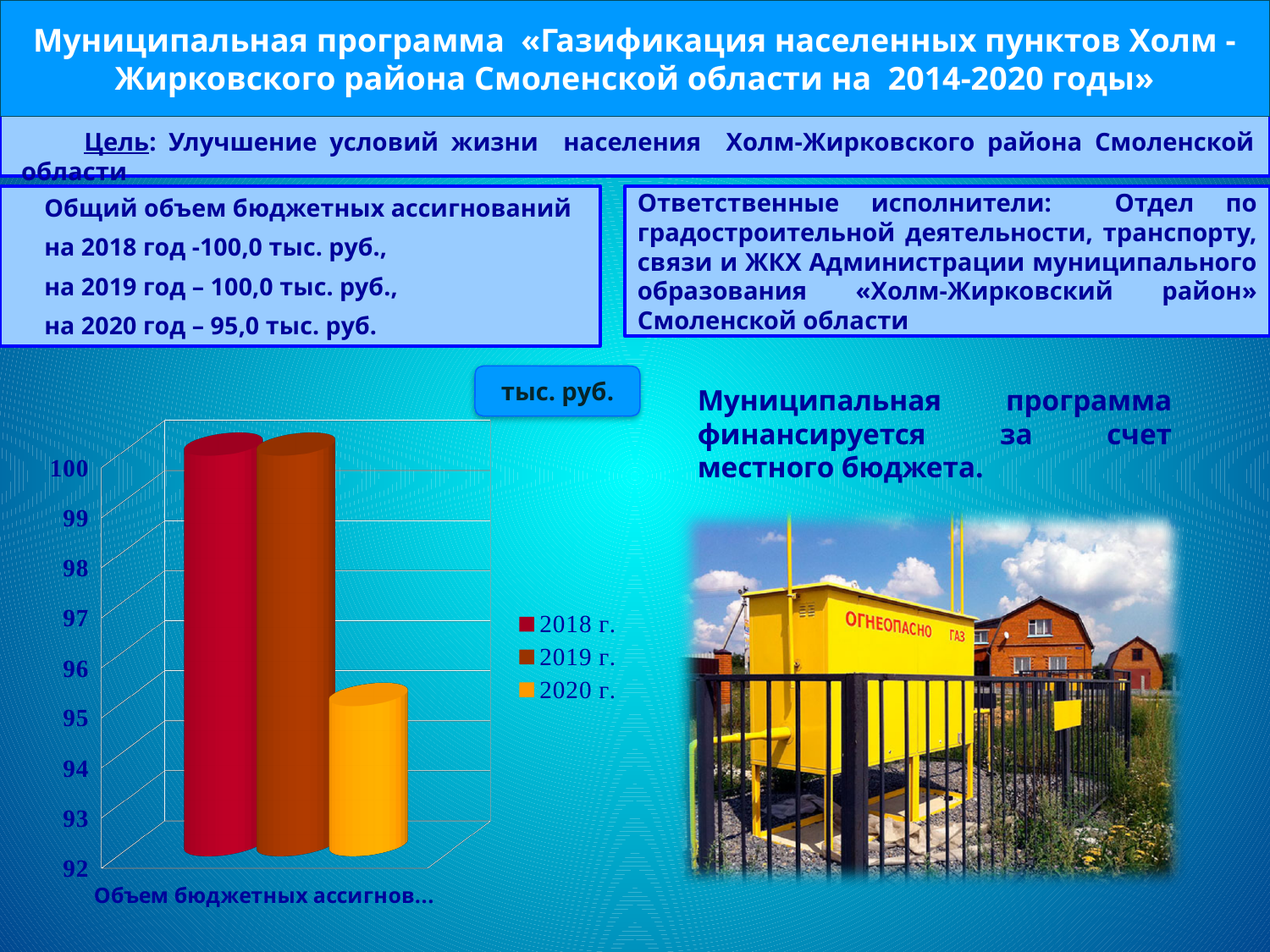
What unit label is shown above the chart? тыс. руб. Which series has the lowest value in the chart? 2020 г. How many series does the chart legend list? 3 Which is larger in the chart, the value for 2019 г. or the value for 2020 г.? 2019 г. What colour is the bar for 2020 г. in the chart? yellow What is the value for 2018 г. in the chart? 100 What is the value for 2019 г. in the chart? 100 What is the value for 2020 г. in the chart? 95 What kind of chart is shown on the slide? bar chart Is the value for 2020 г. greater or less than 98? less What is the difference between the value for 2018 г. and the value for 2020 г. in the chart? 5 Do the values in the chart rise or fall from 2018 г. to 2020 г.? fall